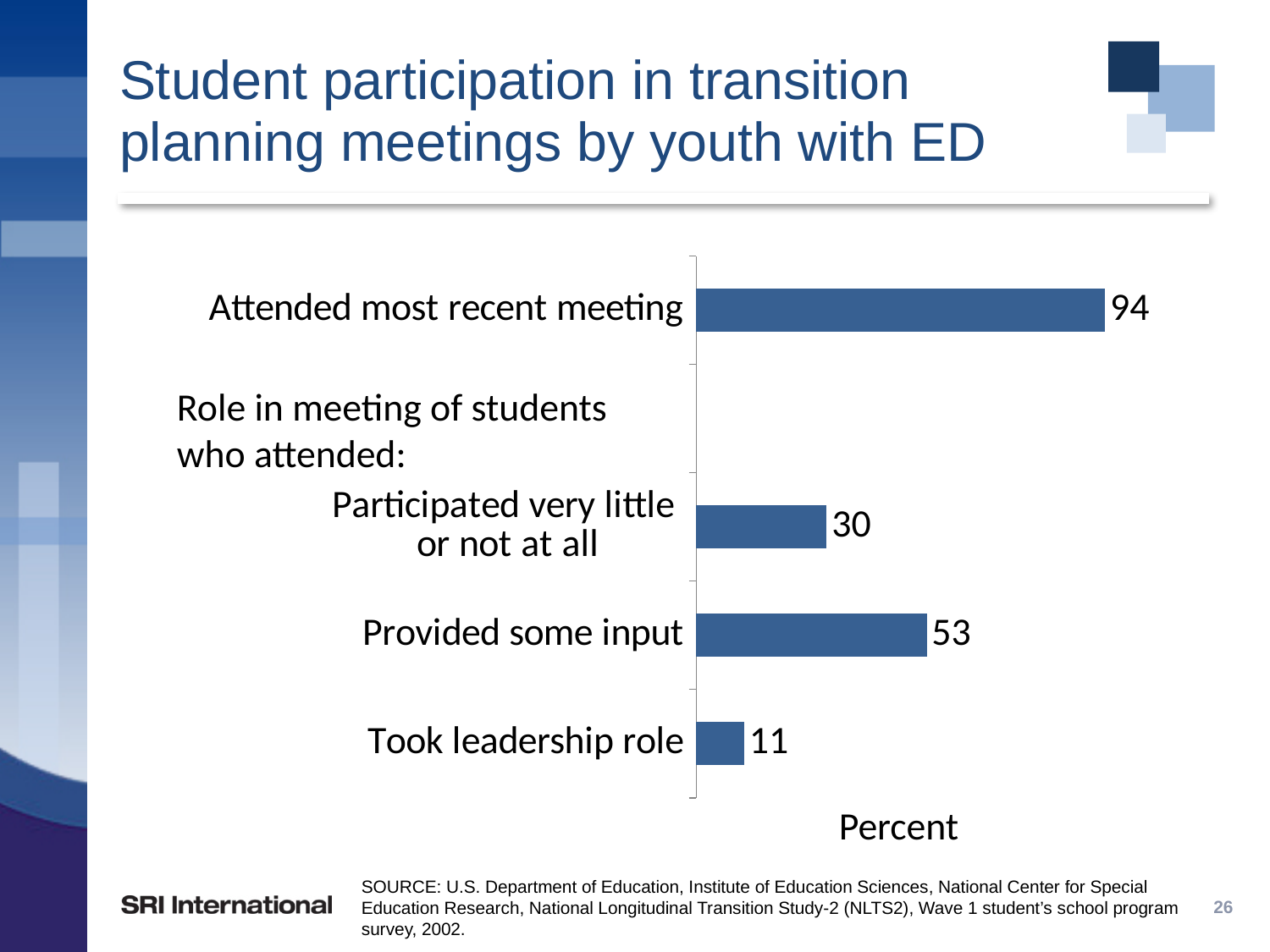
What is the label on the horizontal axis of the chart? Percent What kind of chart is shown on the slide? Bar chart Which category has the lowest value? Took leadership role Which is larger: 'Provided some input' or 'Participated very little or not at all'? Provided some input How many bars are plotted in the chart? 4 What is the value for 'Participated very little or not at all'? 30 What is the value for 'Took leadership role'? 11 What percentage of youth with ED attended the most recent transition planning meeting? 94 What is the difference between 'Provided some input' and 'Participated very little or not at all'? 23 What is the difference between 'Attended most recent meeting' and 'Took leadership role'? 83 Which category has the highest value? Attended most recent meeting What is the value for 'Provided some input'? 53